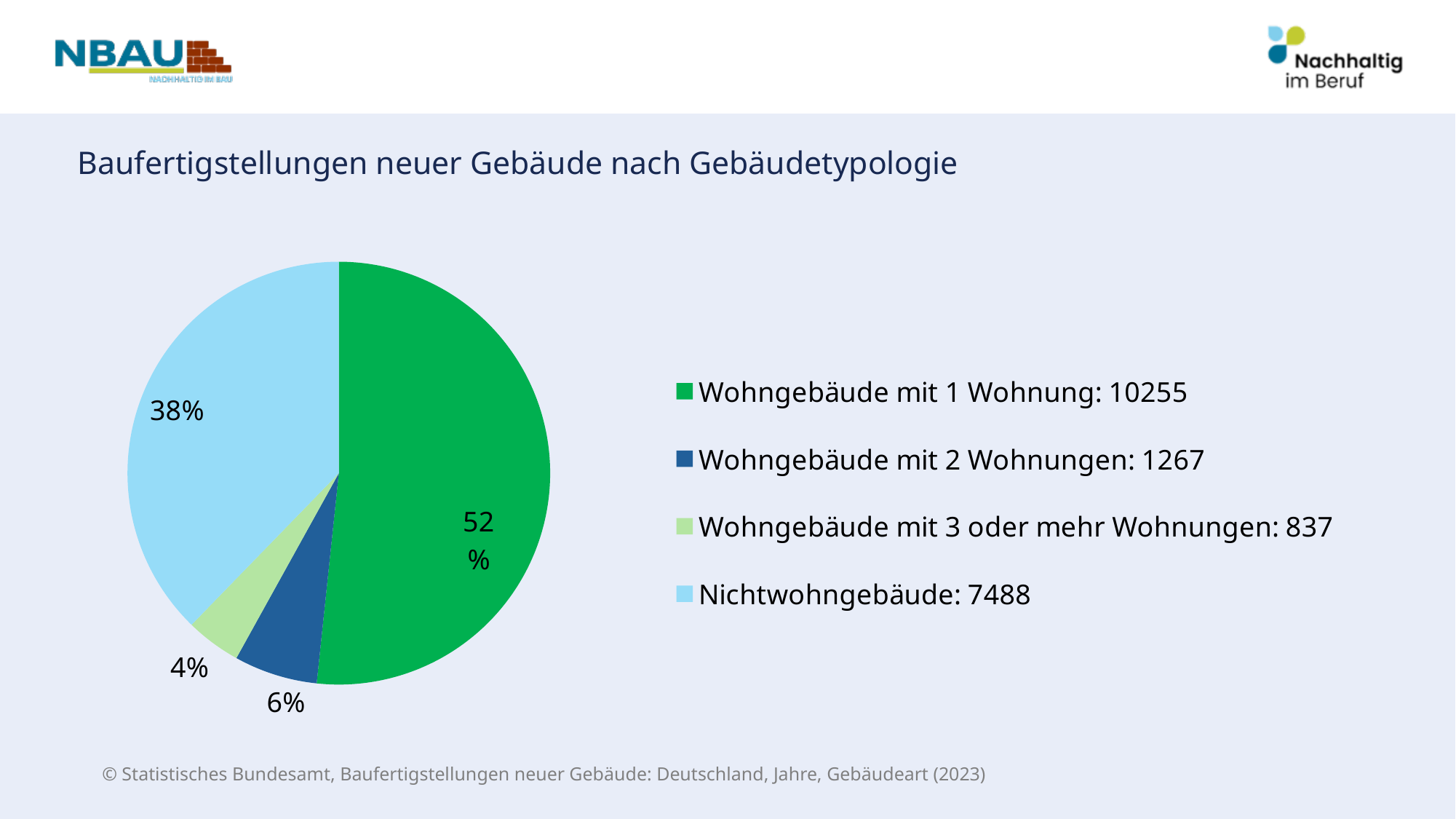
What is the value given in the legend for Nichtwohngebäude? 7488 What is the value given in the legend for Wohngebäude mit 2 Wohnungen? 1267 What share of the pie does Wohngebäude mit 1 Wohnung represent? 52% Which category has the largest slice of the pie? Wohngebäude mit 1 Wohnung Which category has the smallest slice of the pie? Wohngebäude mit 3 oder mehr Wohnungen What is the difference between the values for Wohngebäude mit 1 Wohnung and Nichtwohngebäude? 2767 What share of the pie does Nichtwohngebäude represent? 38% What share of the pie does Wohngebäude mit 3 oder mehr Wohnungen represent? 4% How many categories does the pie chart show? 4 Which is larger, the value for Wohngebäude mit 2 Wohnungen or Wohngebäude mit 3 oder mehr Wohnungen? Wohngebäude mit 2 Wohnungen What kind of chart is shown on the slide? pie chart